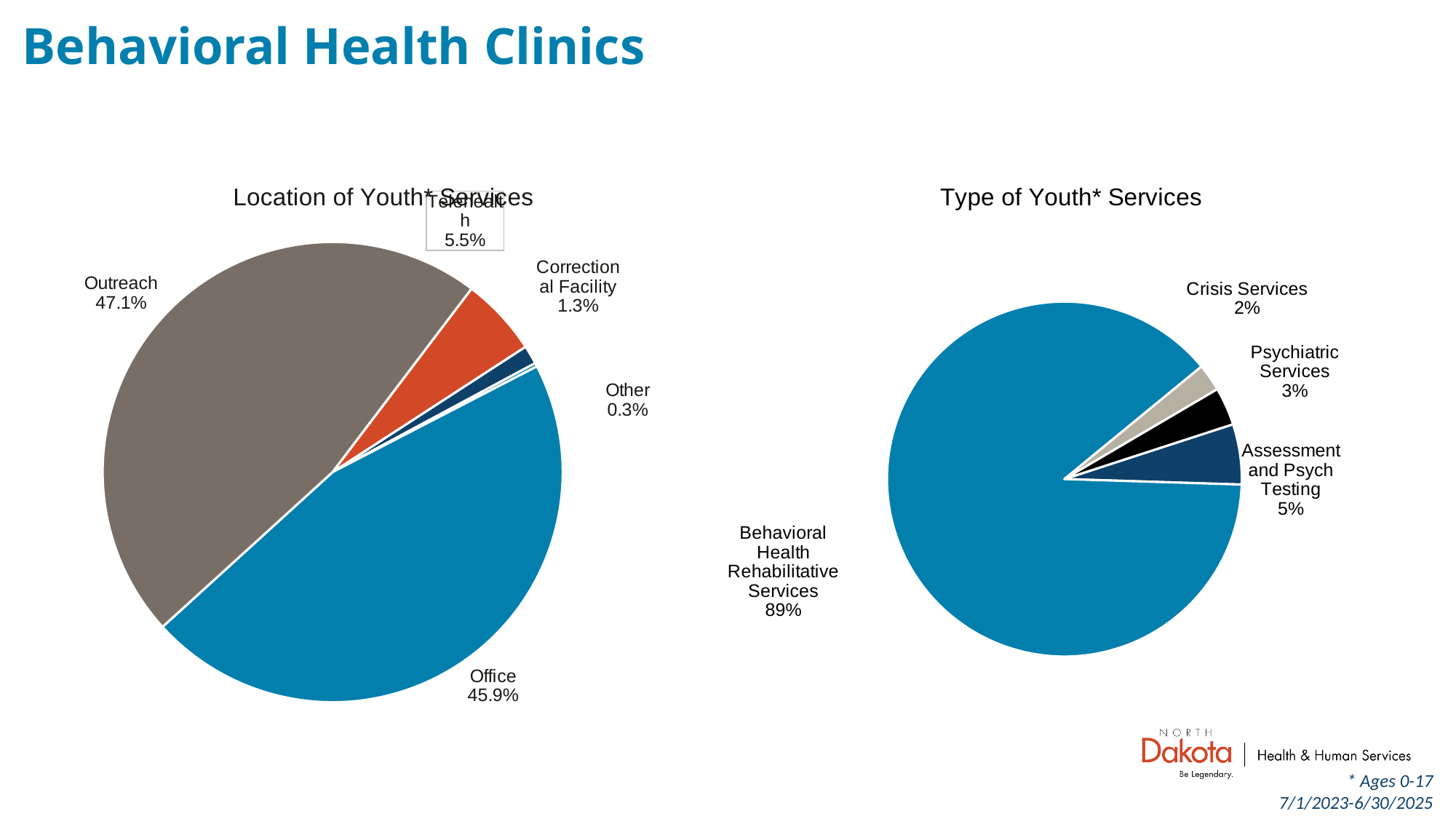
In the 'Type of Youth* Services' chart, what share is Assessment and Psych Testing? 5% In the 'Location of Youth* Services' chart, how many slices does the pie have? 5 In the 'Type of Youth* Services' chart, what share is Behavioral Health Rehabilitative Services? 89% In the 'Location of Youth* Services' chart, what share of services is Correctional Facility? 1.3% In the 'Location of Youth* Services' chart, which location has the largest share? Outreach In the 'Location of Youth* Services' chart, which location has the smallest share? Other In the 'Type of Youth* Services' chart, which is larger, Psychiatric Services or Crisis Services? Psychiatric Services In the 'Type of Youth* Services' chart, how many service types are shown? 4 What kind of chart is the 'Type of Youth* Services' chart? Pie chart In the 'Location of Youth* Services' chart, what is the difference between the Outreach and Office shares? 1.2% In the 'Location of Youth* Services' chart, what share of services is Outreach? 47.1% In the 'Location of Youth* Services' chart, what share of services is Office? 45.9%